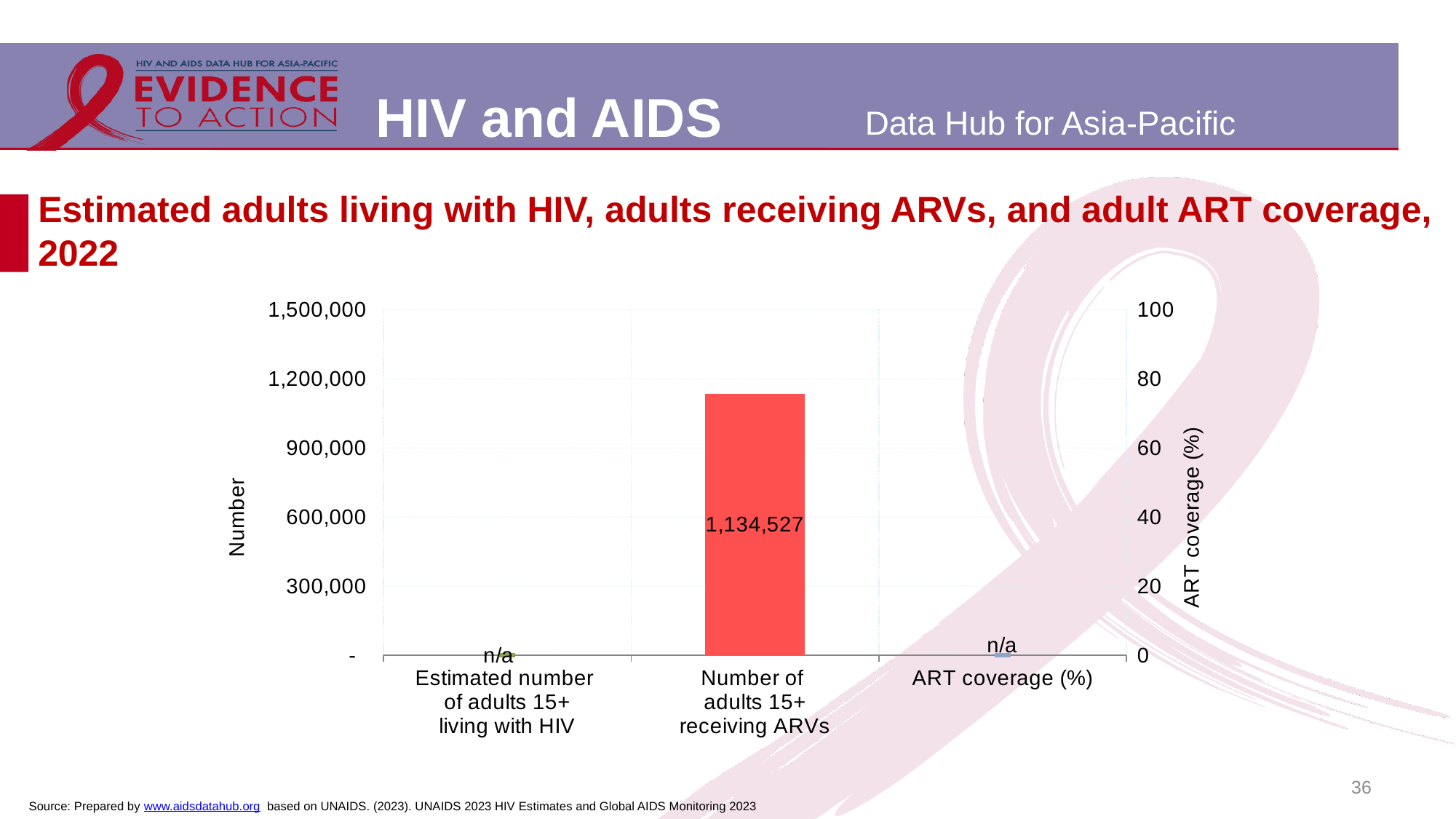
What is the title of the right vertical axis? ART coverage (%) What is the title of the left vertical axis? Number Which category has the highest plotted value? Number of adults 15+ receiving ARVs How many categories are shown on the x axis? 3 What is the value shown for Number of adults 15+ receiving ARVs? 1,134,527 What is the maximum value shown on the left vertical axis? 1,500,000 Is the value for Number of adults 15+ receiving ARVs greater or less than 1,200,000? less What kind of chart is shown on the slide? Bar chart Is the value for Number of adults 15+ receiving ARVs greater or less than 900,000? greater What label is shown for ART coverage (%)? n/a What label is shown for the Estimated number of adults 15+ living with HIV? n/a How many categories are marked n/a? 2